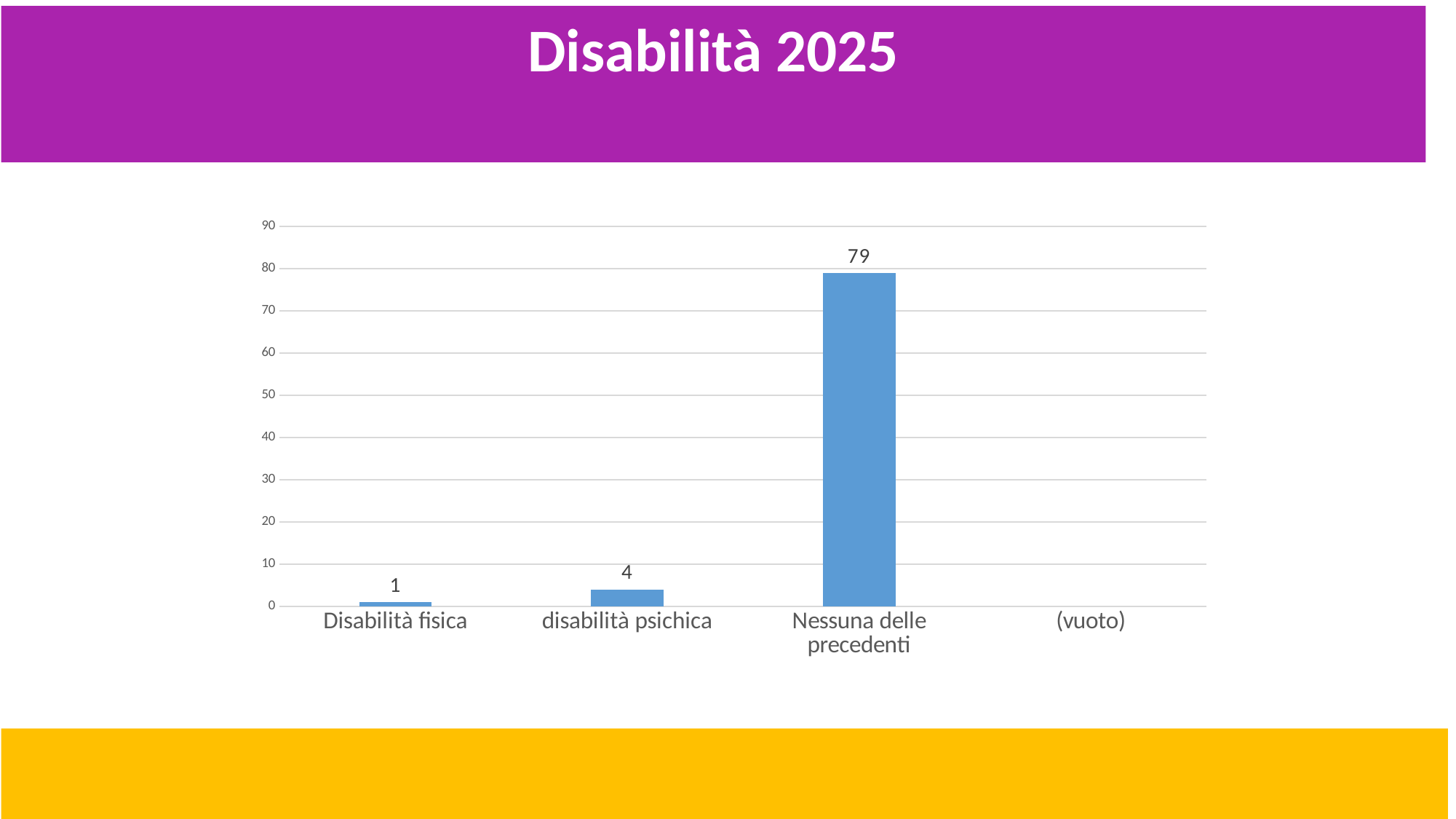
Which is larger, the value for disabilità psichica or the value for Disabilità fisica? disabilità psichica What is the value for Disabilità fisica? 1 What is the difference between the values for Nessuna delle precedenti and disabilità psichica? 75 Which category with a visible bar has the lowest value? Disabilità fisica Which category has the highest value? Nessuna delle precedenti How many categories are shown on the x axis? 4 What is the title of the slide? Disabilità 2025 What kind of chart is shown on the slide? bar chart What is the value for disabilità psichica? 4 What is the value for Nessuna delle precedenti? 79 Is the value for Nessuna delle precedenti greater or less than 70? greater What is the difference between the values for disabilità psichica and Disabilità fisica? 3